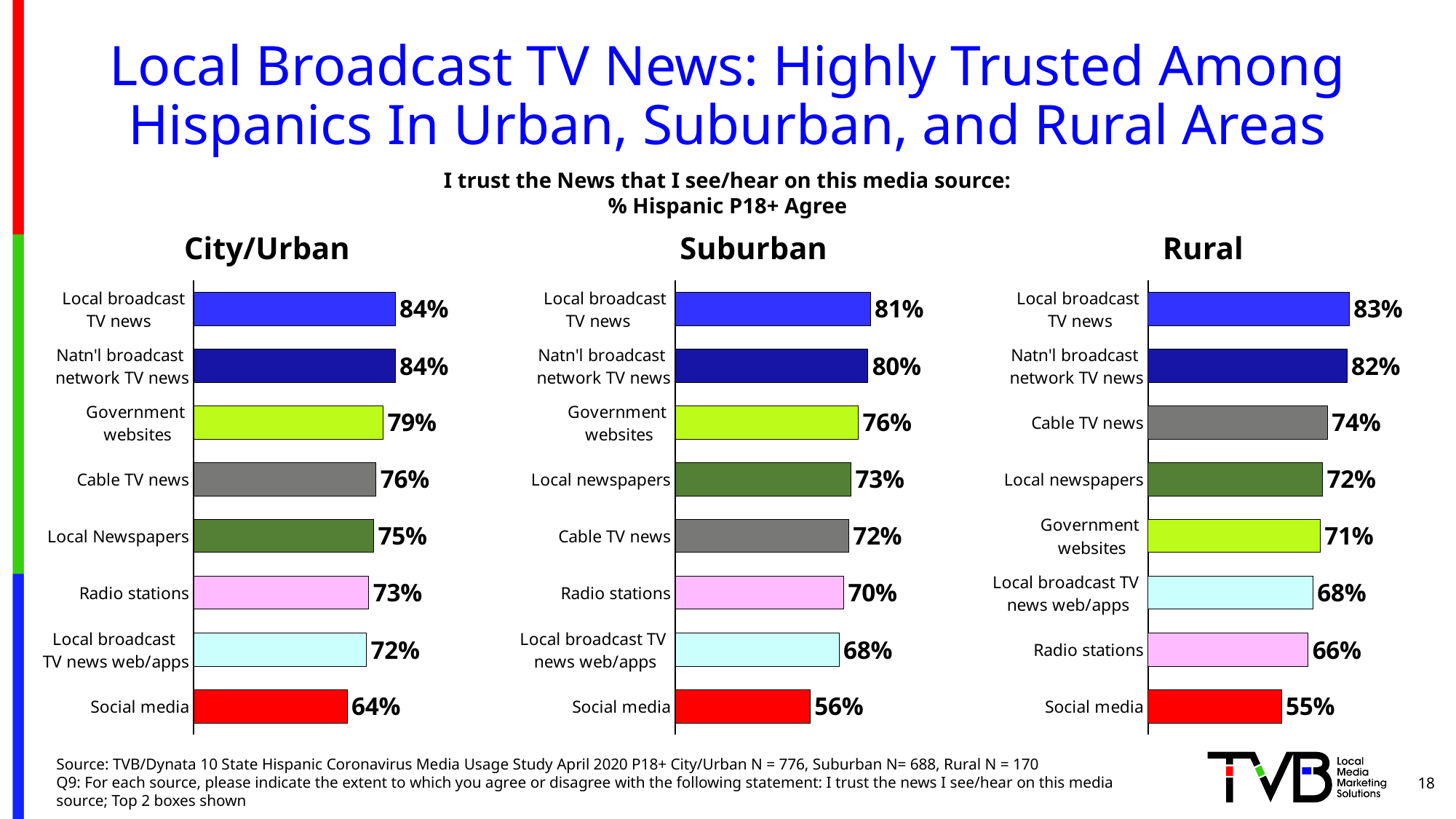
How many charts are shown on the slide? 3 In the Suburban chart, what is the value for Local newspapers? 73% In the City/Urban chart, what is the difference between Local broadcast TV news and Social media? 20% What type of chart is the Rural chart? Bar chart In the Suburban chart, which category has the lowest value? Social media In the City/Urban chart, what colour is the Social media bar? Red How many categories are shown in the Suburban chart? 8 In the Rural chart, what is the difference between Cable TV news and Government websites? 3% In the City/Urban chart, what is the value for Government websites? 79% In the Rural chart, what is the value for Radio stations? 66% In the Suburban chart, which is larger: Government websites or Radio stations? Government websites In the Rural chart, which category has the highest value? Local broadcast TV news